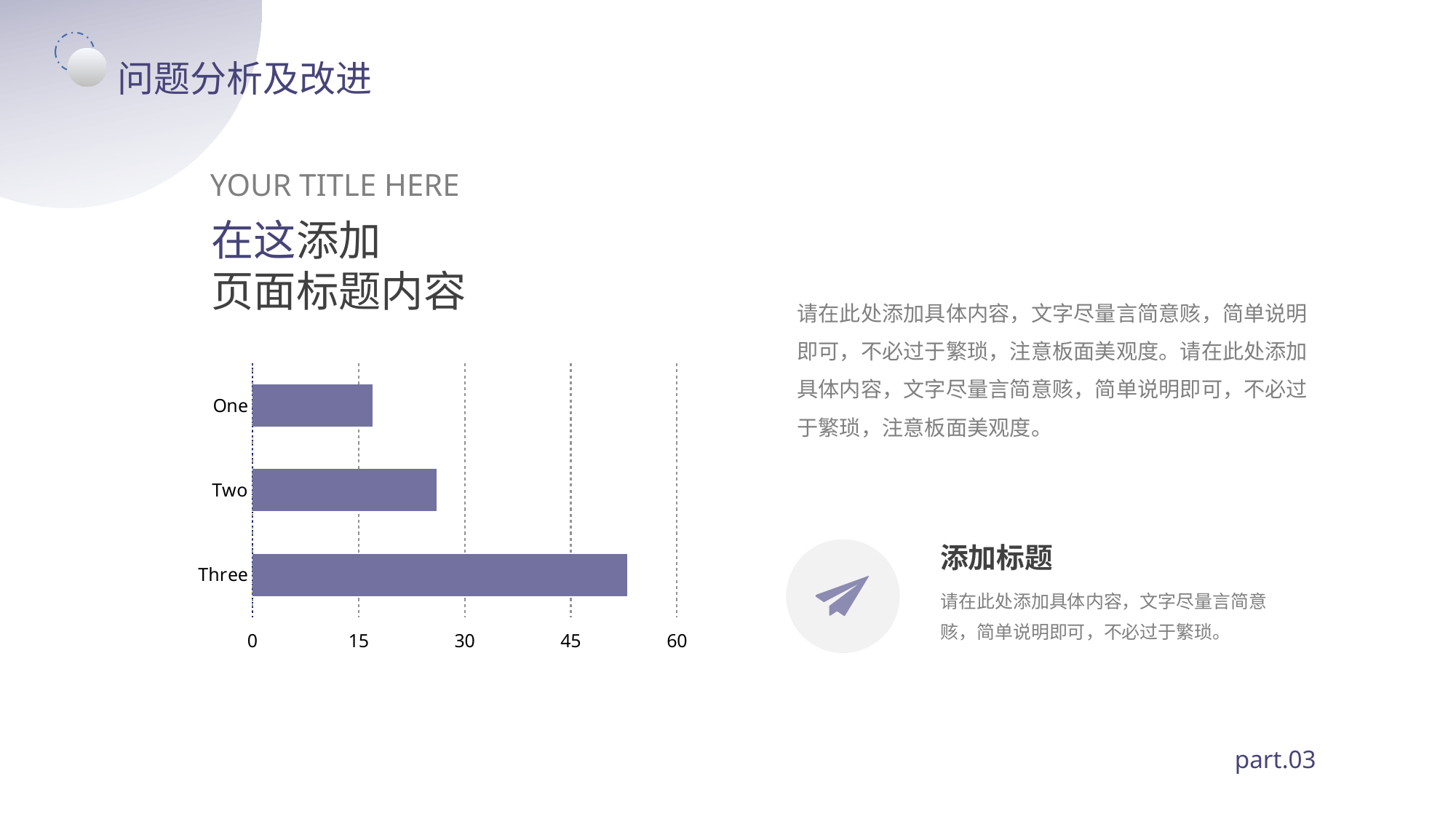
Is the value for Two greater or less than 15? greater Is the value for Three greater or less than 45? greater Which category has the highest value in the bar chart? Three Is the value for One greater or less than 30? less What kind of chart is shown on the slide? bar chart What is the highest value shown on the chart's horizontal axis? 60 Which category has the lowest value in the bar chart? One Which has the larger value, Two or Three? Three How many categories does the bar chart show? 3 Which has the larger value, One or Two? Two